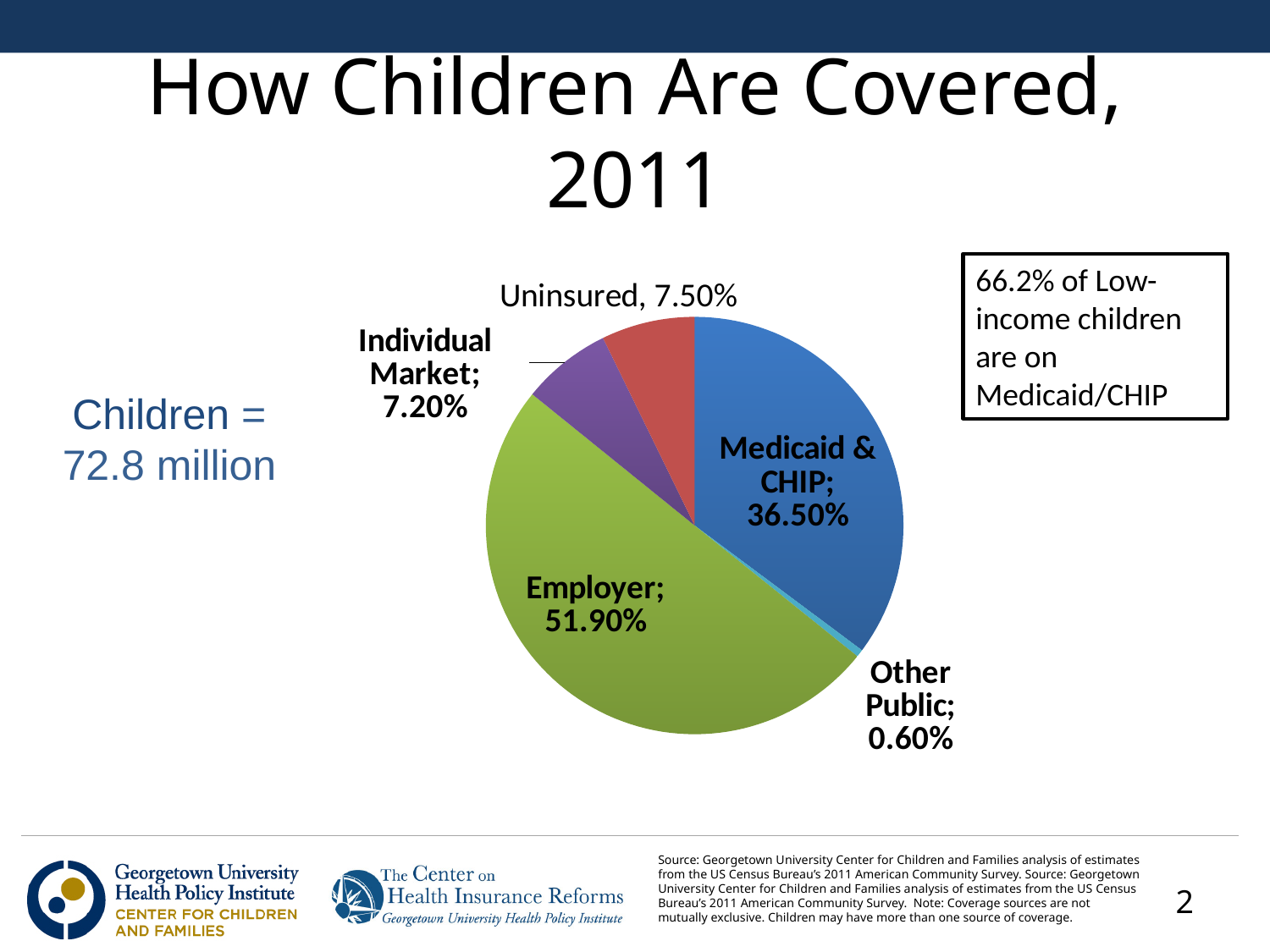
What share of children are covered by Employer coverage? 51.90% What is the value shown for the Uninsured slice? 7.50% What percentage of children are covered through the Individual Market? 7.20% How many slices does the pie chart have? 5 Which is larger, the Uninsured share or the Individual Market share? Uninsured What percentage of children are covered by Medicaid & CHIP? 36.50% What type of chart is shown on the slide? Pie chart What is the title of the slide containing the pie chart? How Children Are Covered, 2011 Which coverage category has the largest slice of the pie? Employer Which coverage category has the smallest slice of the pie? Other Public What is the value for Other Public coverage? 0.60% What is the difference in percentage points between Employer and Medicaid & CHIP coverage? 15.40 percentage points